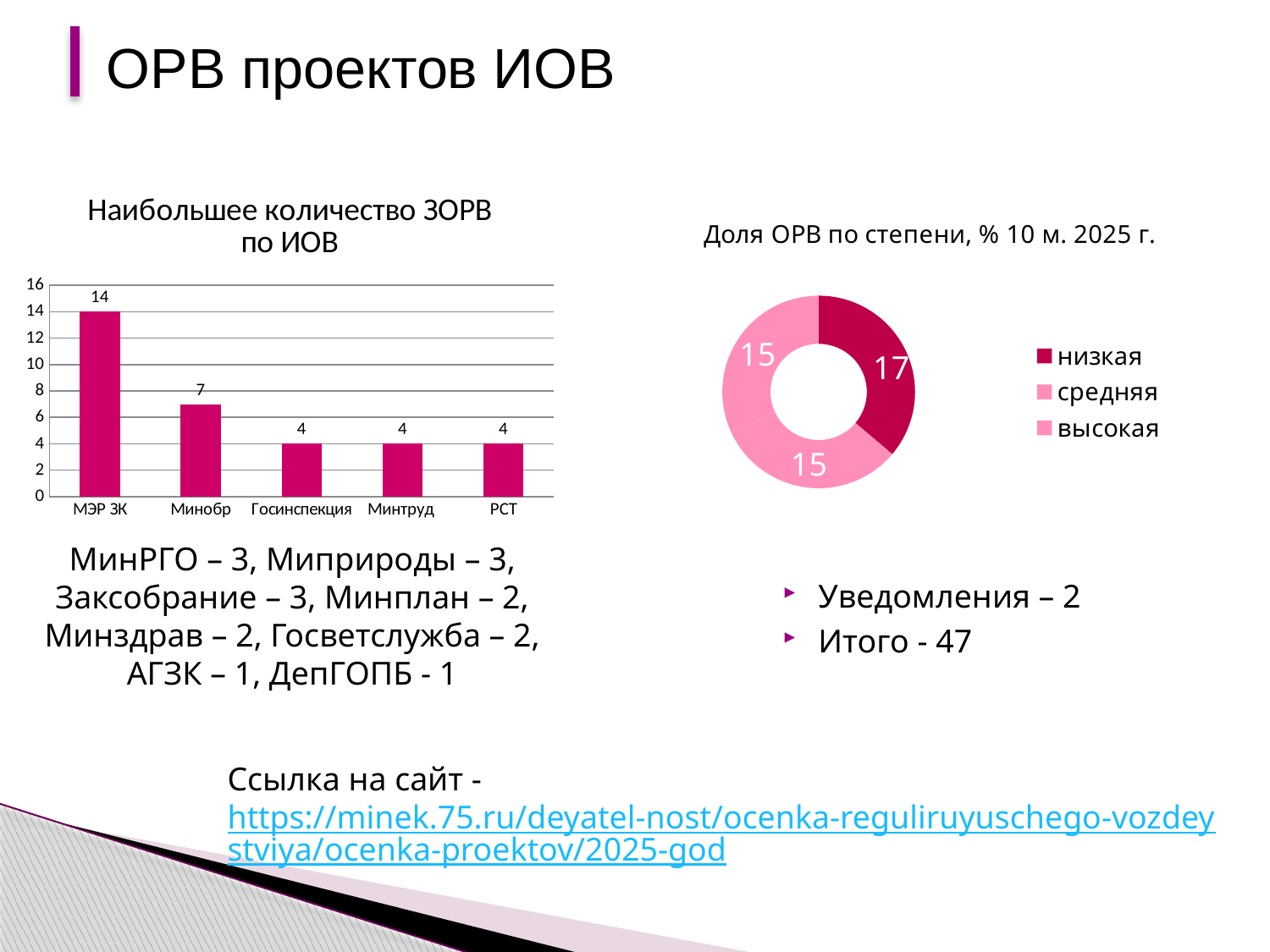
In the chart 'Наибольшее количество ЗОРВ по ИОВ', how many categories are shown on the x axis? 5 In the chart 'Доля ОРВ по степени, % 10 м. 2025 г.', what is the value for низкая? 17 In the chart 'Наибольшее количество ЗОРВ по ИОВ', what is the difference between the values for МЭР ЗК and Минобр? 7 In the chart 'Наибольшее количество ЗОРВ по ИОВ', which is larger, the value for Минобр or the value for Минтруд? Минобр In the chart 'Наибольшее количество ЗОРВ по ИОВ', what is the value for Минобр? 7 In the chart 'Доля ОРВ по степени, % 10 м. 2025 г.', which category has the largest segment? низкая In the chart 'Наибольшее количество ЗОРВ по ИОВ', what is the value for МЭР ЗК? 14 In the chart 'Наибольшее количество ЗОРВ по ИОВ', do the values rise or fall from left to right? fall What kind of chart is 'Наибольшее количество ЗОРВ по ИОВ'? bar chart In the chart 'Наибольшее количество ЗОРВ по ИОВ', which category has the highest value? МЭР ЗК In the chart 'Доля ОРВ по степени, % 10 м. 2025 г.', how many entries does the legend list? 3 What kind of chart is 'Доля ОРВ по степени, % 10 м. 2025 г.'? doughnut chart